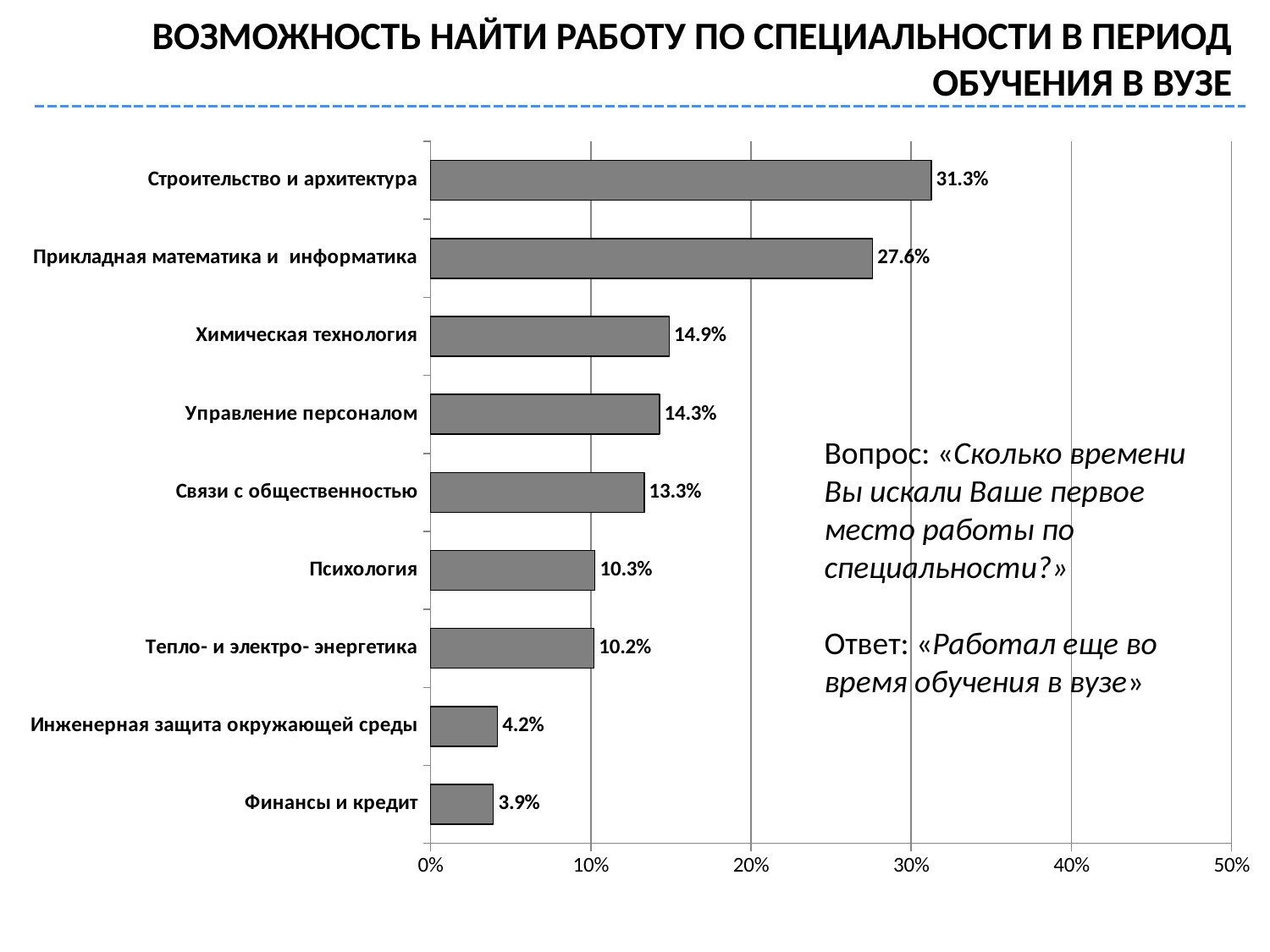
What kind of chart is shown on the slide? bar chart What is the value for Психология? 10.3% What is the maximum value shown on the horizontal axis? 50% What is the difference between the values for Строительство и архитектура and Прикладная математика и информатика? 3.7% What is the difference between the values for Инженерная защита окружающей среды and Финансы и кредит? 0.3% Which is larger, the value for Химическая технология or the value for Управление персоналом? Химическая технология How many categories are shown in the chart? 9 What is the value for Строительство и архитектура? 31.3% Which category has the lowest value? Финансы и кредит What is the value for Финансы и кредит? 3.9% Is the value for Связи с общественностью greater or less than 10%? greater Which category has the highest value? Строительство и архитектура